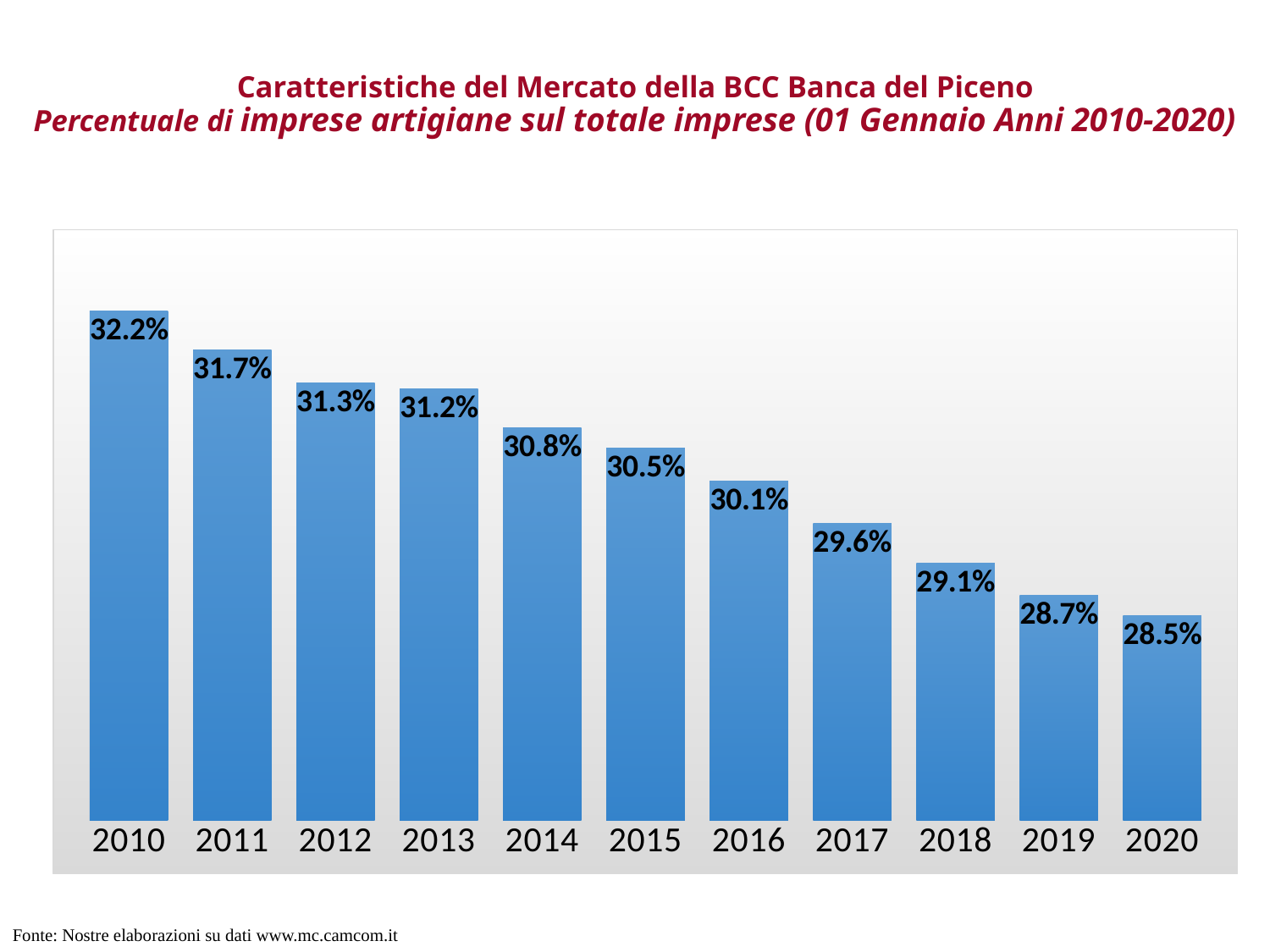
What kind of chart is this? bar chart Which year has the highest percentage? 2010 What is the percentage of artisan enterprises in 2010? 32.2% Which year has the lowest percentage? 2020 What is the difference between the 2014 value and the 2015 value? 0.3% What is the value shown for 2016? 30.1% What is the value shown for 2020? 28.5% What is the difference between the 2010 value and the 2020 value? 3.7% Which is larger, the value for 2013 or the value for 2018? 2013 Do the values rise or fall from 2010 to 2020? fall What is the source cited at the bottom of the slide? Nostre elaborazioni su dati www.mc.camcom.it How many years are shown on the x axis? 11